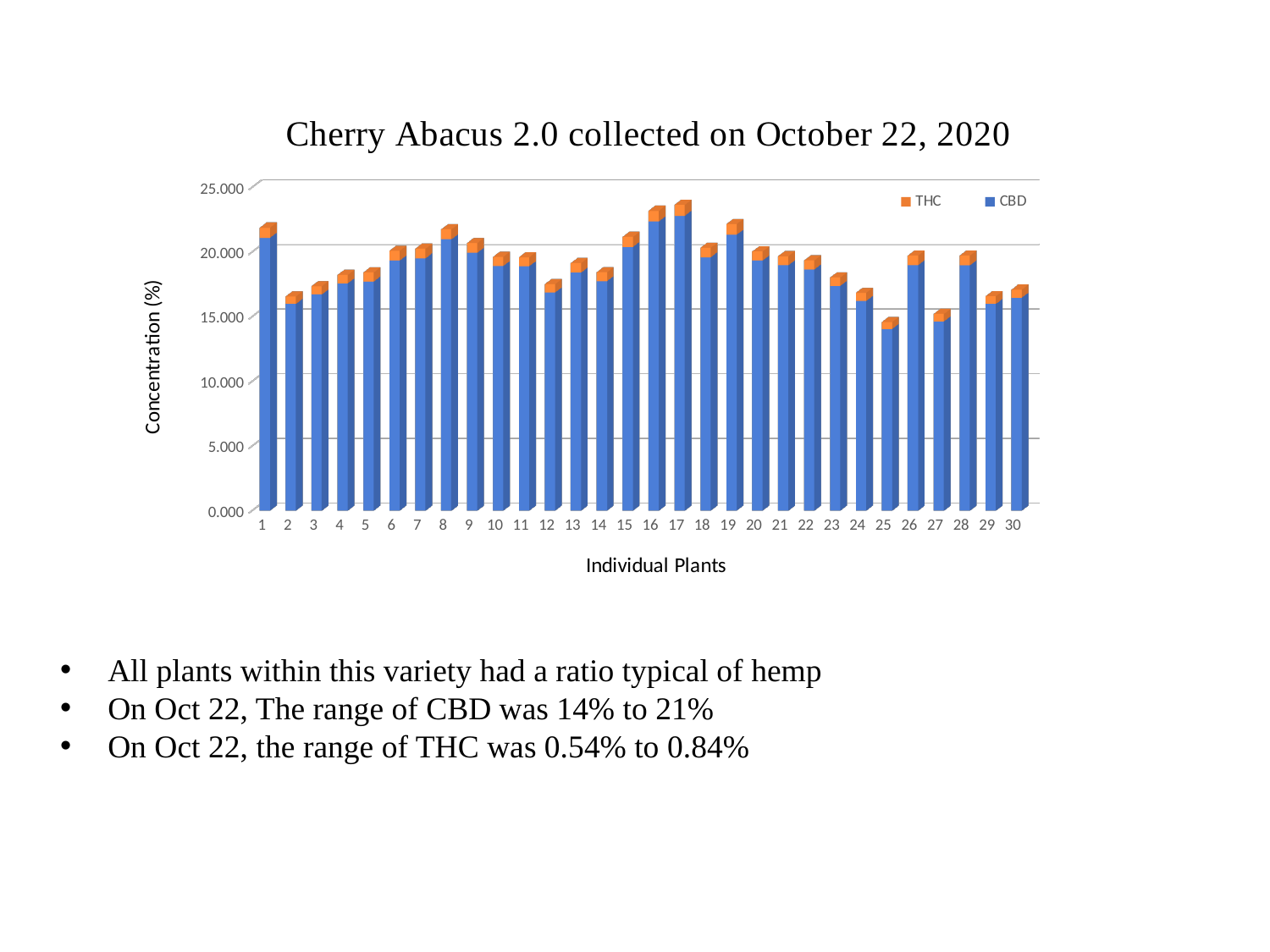
Is the total concentration for plant 16 greater or less than 20.000? greater Is the total concentration for plant 2 greater or less than 20.000? less Is the total concentration for plant 1 greater or less than 20.000? greater How many series does the legend list? 2 Which has the larger total concentration, plant 17 or plant 25? Plant 17 What kind of chart is shown on the slide? Stacked bar chart Which two series are listed in the legend? THC and CBD How many individual plants are plotted on the x axis? 30 What is the label of the y axis? Concentration (%) Which plant has the lowest total concentration? 25 Which has the larger total concentration, plant 1 or plant 2? Plant 1